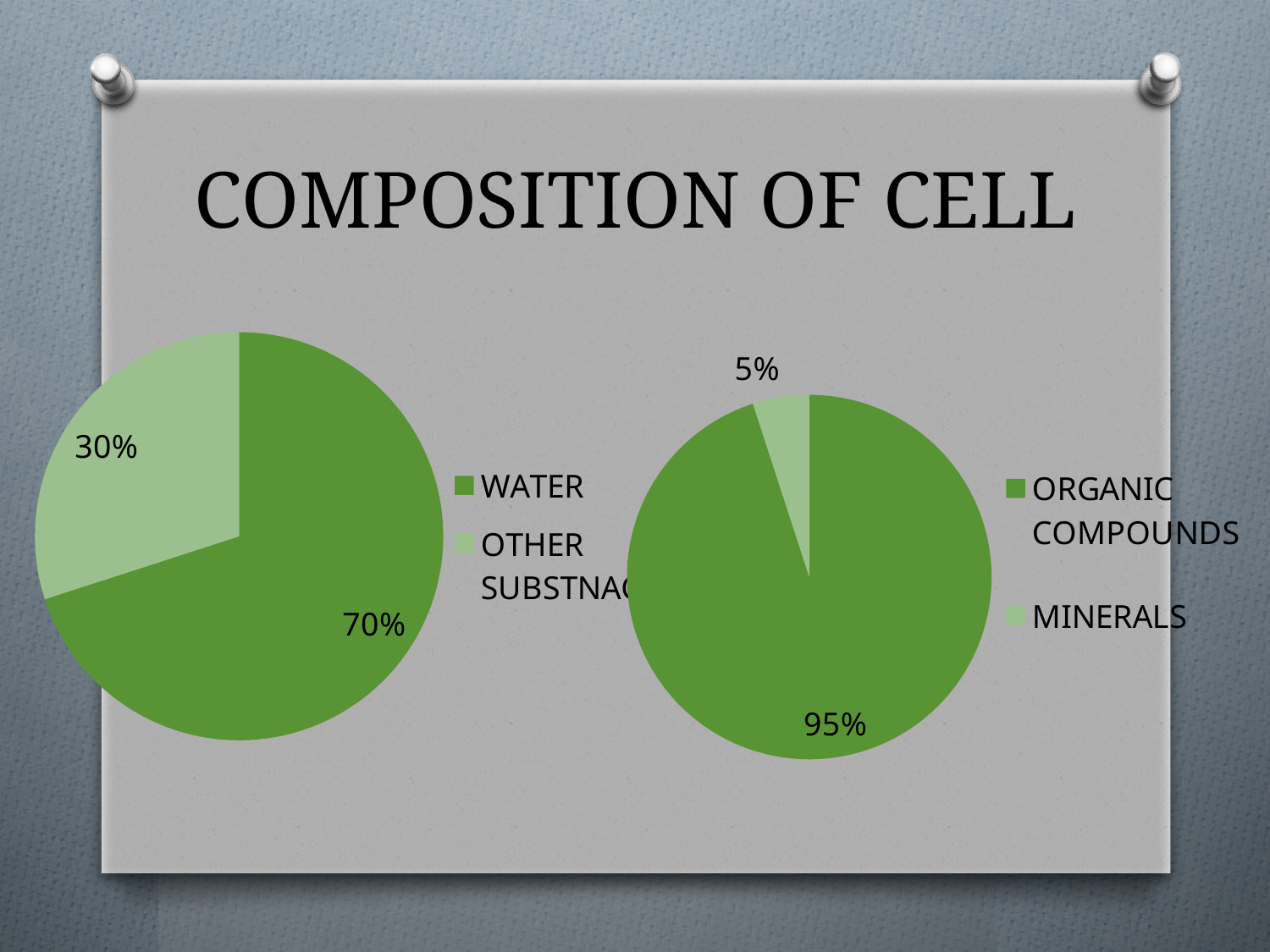
In the left pie chart, what percentage is shown for OTHER SUBSTNACES? 30% In the left pie chart, which category has the largest slice? WATER How many slices does the left pie chart have? 2 In the right pie chart, what percentage is shown for ORGANIC COMPOUNDS? 95% What is the title of the slide containing the two charts? COMPOSITION OF CELL What type of chart is the right chart on the slide? Pie chart In the right pie chart, what percentage is shown for MINERALS? 5% In the right pie chart, what is the difference in percentage points between ORGANIC COMPOUNDS and MINERALS? 90 In the right pie chart, which category has the smallest slice? MINERALS In the right pie chart, which is larger, ORGANIC COMPOUNDS or MINERALS? ORGANIC COMPOUNDS In the left pie chart, what is the difference in percentage points between WATER and OTHER SUBSTNACES? 40 In the left pie chart, what percentage is shown for WATER? 70%